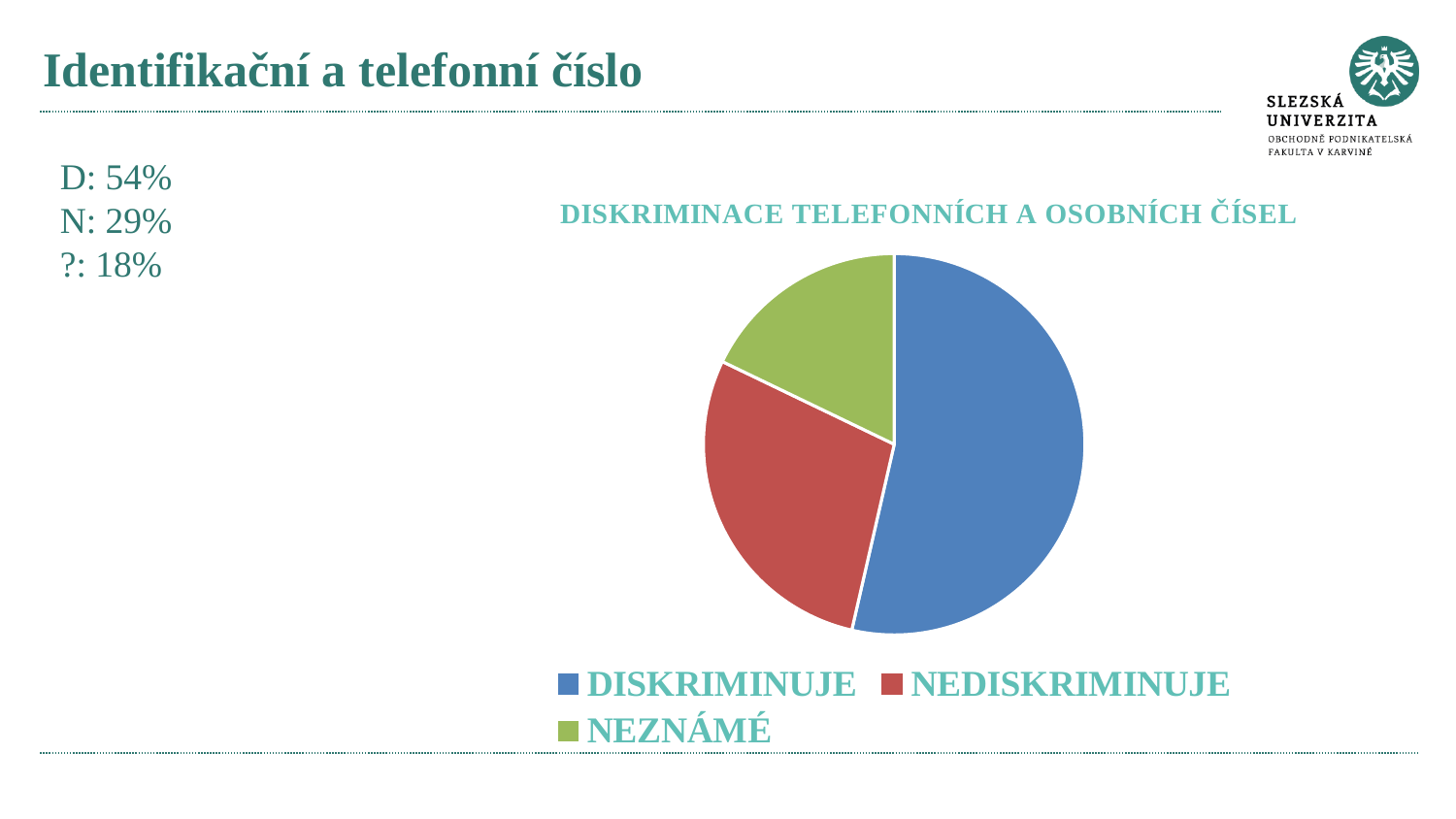
How many slices does the pie chart have? 3 Using the percentages printed on the slide, how much larger is the DISKRIMINUJE (D) share than the NEDISKRIMINUJE (N) share? 25% What is the title of the pie chart? DISKRIMINACE TELEFONNÍCH A OSOBNÍCH ČÍSEL What kind of chart is shown on the slide? pie chart According to the percentages printed on the slide, what share of the pie does NEZNÁMÉ (?) represent? 18% Which category has the smallest slice of the pie chart? NEZNÁMÉ Which slice is larger, DISKRIMINUJE or NEDISKRIMINUJE? DISKRIMINUJE Which slice is larger, NEDISKRIMINUJE or NEZNÁMÉ? NEDISKRIMINUJE According to the percentages printed on the slide, what share of the pie does DISKRIMINUJE (D) represent? 54% What colour is the DISKRIMINUJE slice in the pie chart? blue How many entries does the legend of the pie chart list? 3 Which category has the largest slice of the pie chart? DISKRIMINUJE